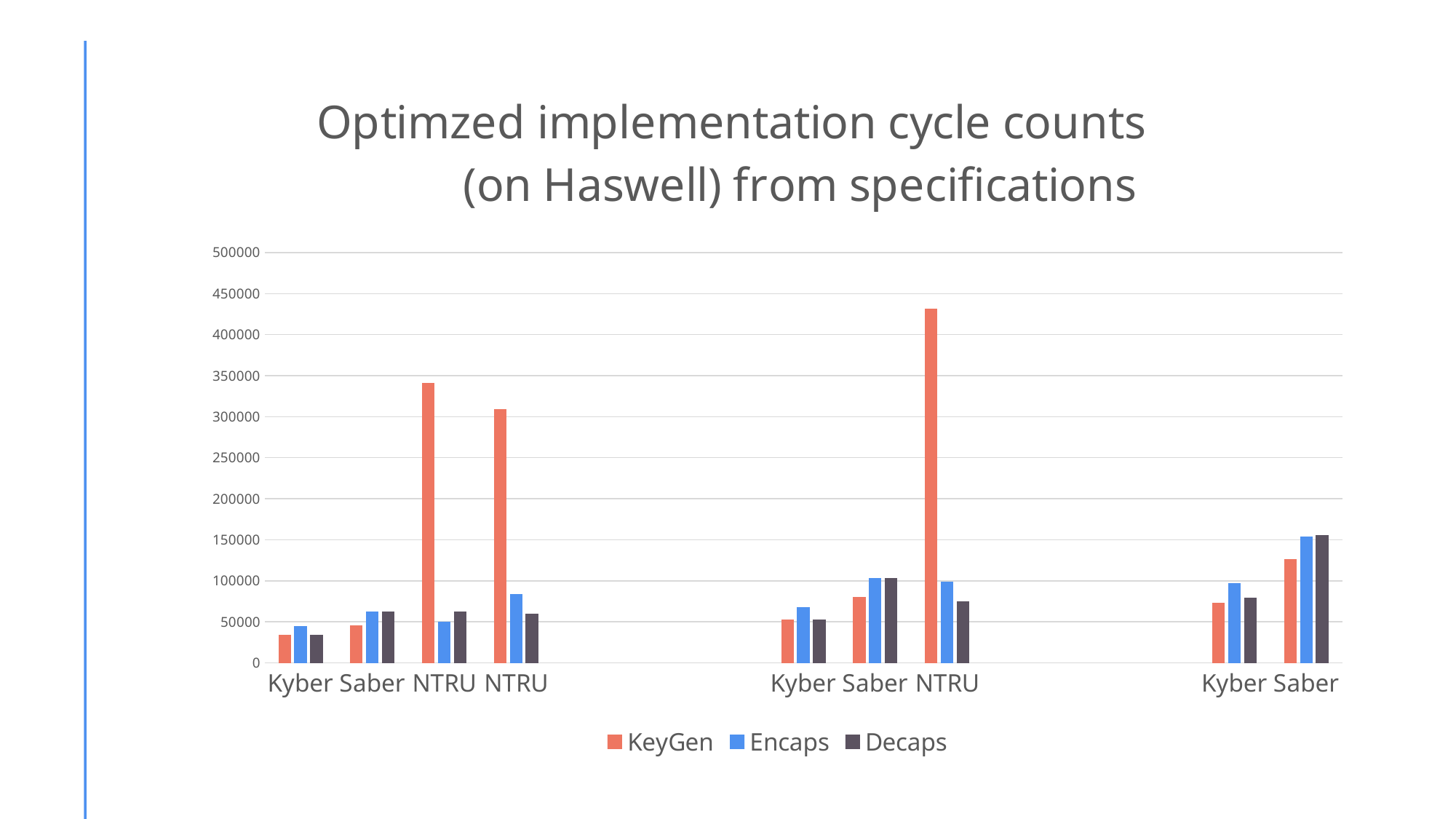
Is the KeyGen value for the NTRU in the middle group (the tallest bar) greater or less than 400000? greater For the leftmost Saber, which series has the lowest value? KeyGen Across the middle group (Kyber, Saber, NTRU), do the KeyGen values rise or fall from left to right? rise How many series does the legend list? 3 How many category labels appear along the x axis? 9 Is the KeyGen value for the leftmost Kyber greater or less than 50000? less Is the KeyGen value for the leftmost NTRU (third category from the left) greater or less than 300000? greater What are the three series named in the legend? KeyGen, Encaps, Decaps Which series has the tallest bar anywhere on the chart? KeyGen What kind of chart is shown on the slide? bar chart In the rightmost group, which has the larger KeyGen value, Kyber or Saber? Saber